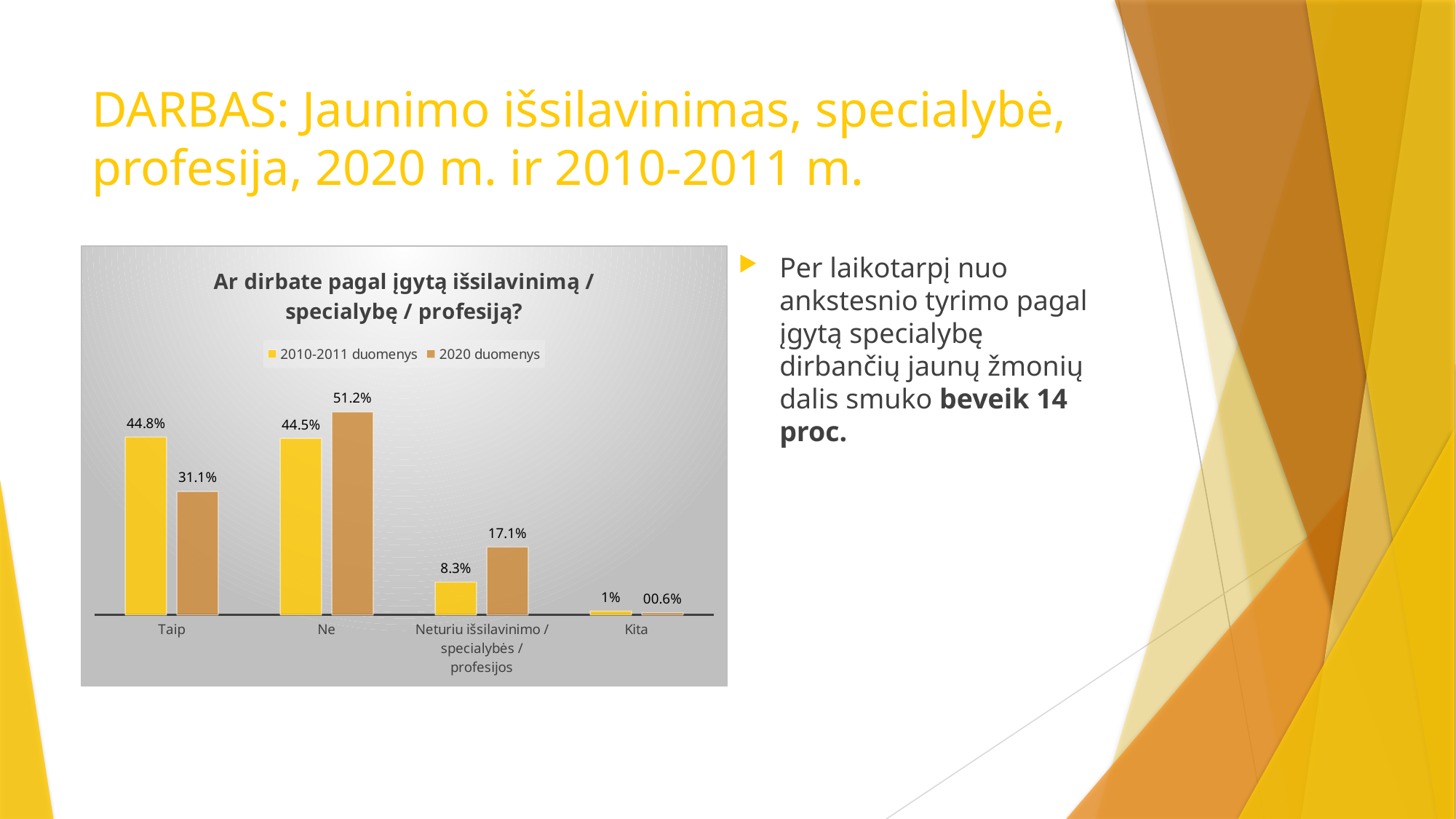
What kind of chart is shown on the slide? Bar chart What is the value for "Taip" in the 2020 duomenys series? 31.1% Which is larger for "Ne": the 2010-2011 duomenys value or the 2020 duomenys value? 2020 duomenys What is the value for "Taip" in the 2010-2011 duomenys series? 44.8% Which category has the highest value in the 2020 duomenys series? Ne What is the value for "Neturiu išsilavinimo / specialybės / profesijos" in the 2010-2011 duomenys series? 8.3% Which category has the lowest value in the 2010-2011 duomenys series? Kita What is the difference between the 2010-2011 duomenys and 2020 duomenys values for "Taip"? 13.7% What is the title of the chart? Ar dirbate pagal įgytą išsilavinimą / specialybę / profesiją? How many series does the chart legend list? 2 How many categories are shown on the x axis of the chart? 4 What is the value for "Ne" in the 2020 duomenys series? 51.2%